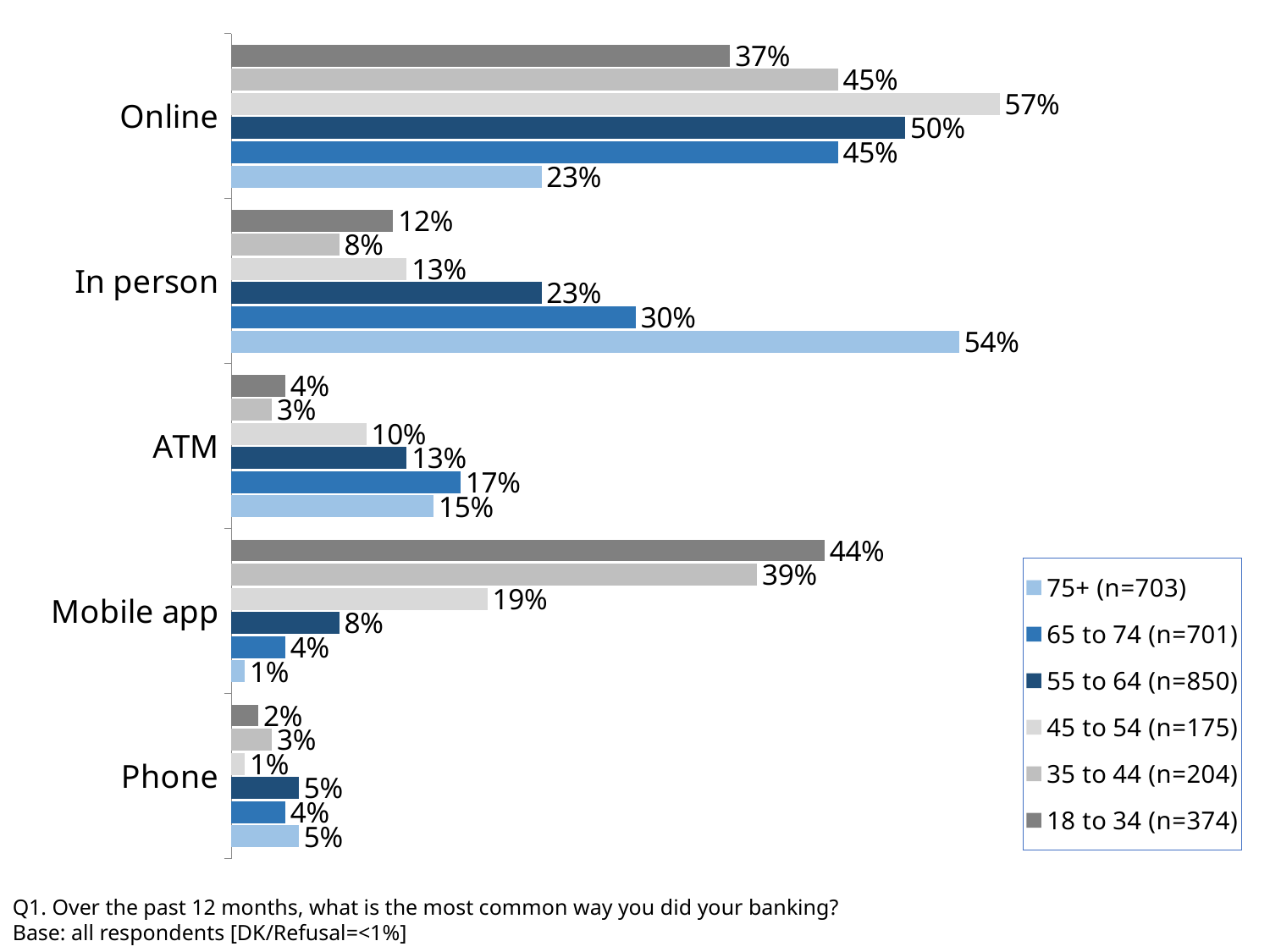
Which age group has the largest sample size (n) according to the legend? 55 to 64 (n=850) What kind of chart is shown on the slide? bar chart How many banking-method categories are shown on the chart? 5 What percentage of the 18 to 34 group used a mobile app? 44% Which age group has the lowest value in the Online category? 75+ Which age group has the highest value in the Mobile app category? 18 to 34 What percentage of the 75+ group did their banking in person? 54% How many series does the legend list? 6 What is the difference between the 75+ and 18 to 34 values in the In person category? 42% In the Online category, which is larger: the value for 55 to 64 or the value for 18 to 34? 55 to 64 What is the value for the 45 to 54 group in the Online category? 57% What is the value for the 65 to 74 group in the ATM category? 17%